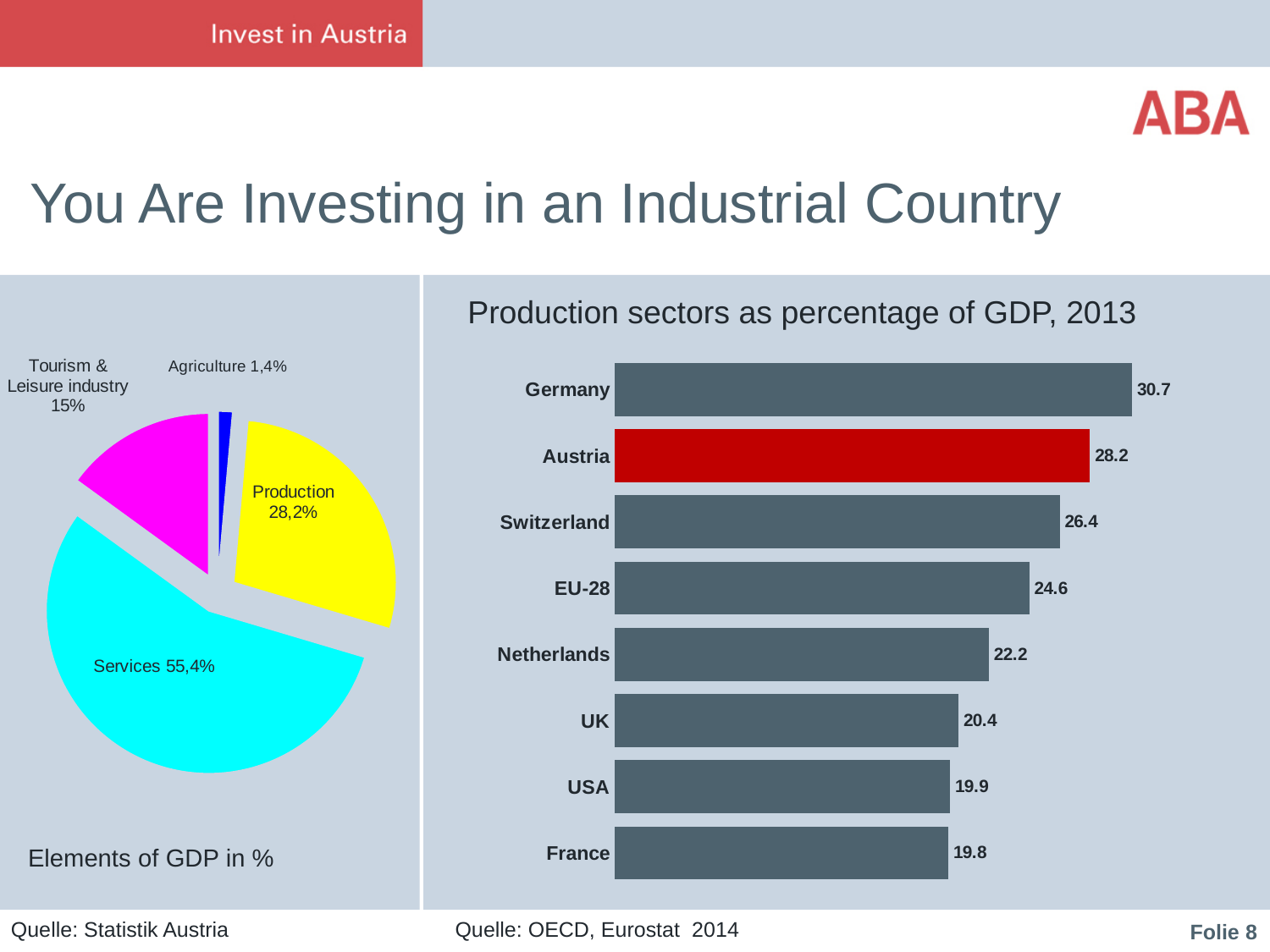
In the 'Production sectors as percentage of GDP, 2013' chart, which is larger, Switzerland or the Netherlands? Switzerland How many slices does the 'Elements of GDP in %' pie chart have? 4 What kind of chart is the 'Production sectors as percentage of GDP, 2013' chart? Bar chart In the 'Production sectors as percentage of GDP, 2013' chart, what is the value for EU-28? 24.6 In the 'Production sectors as percentage of GDP, 2013' chart, which country has the highest value? Germany In the 'Production sectors as percentage of GDP, 2013' chart, what is the difference between Germany and Austria? 2.5 In the 'Production sectors as percentage of GDP, 2013' chart, what is the value for Austria? 28.2 In the 'Production sectors as percentage of GDP, 2013' chart, which category has the lowest value? France In the 'Elements of GDP in %' pie chart, which slice is the smallest? Agriculture How many countries or regions are shown in the 'Production sectors as percentage of GDP, 2013' chart? 8 In the 'Production sectors as percentage of GDP, 2013' chart, which bar is coloured red? Austria In the 'Elements of GDP in %' pie chart, what share does Services have? 55,4%